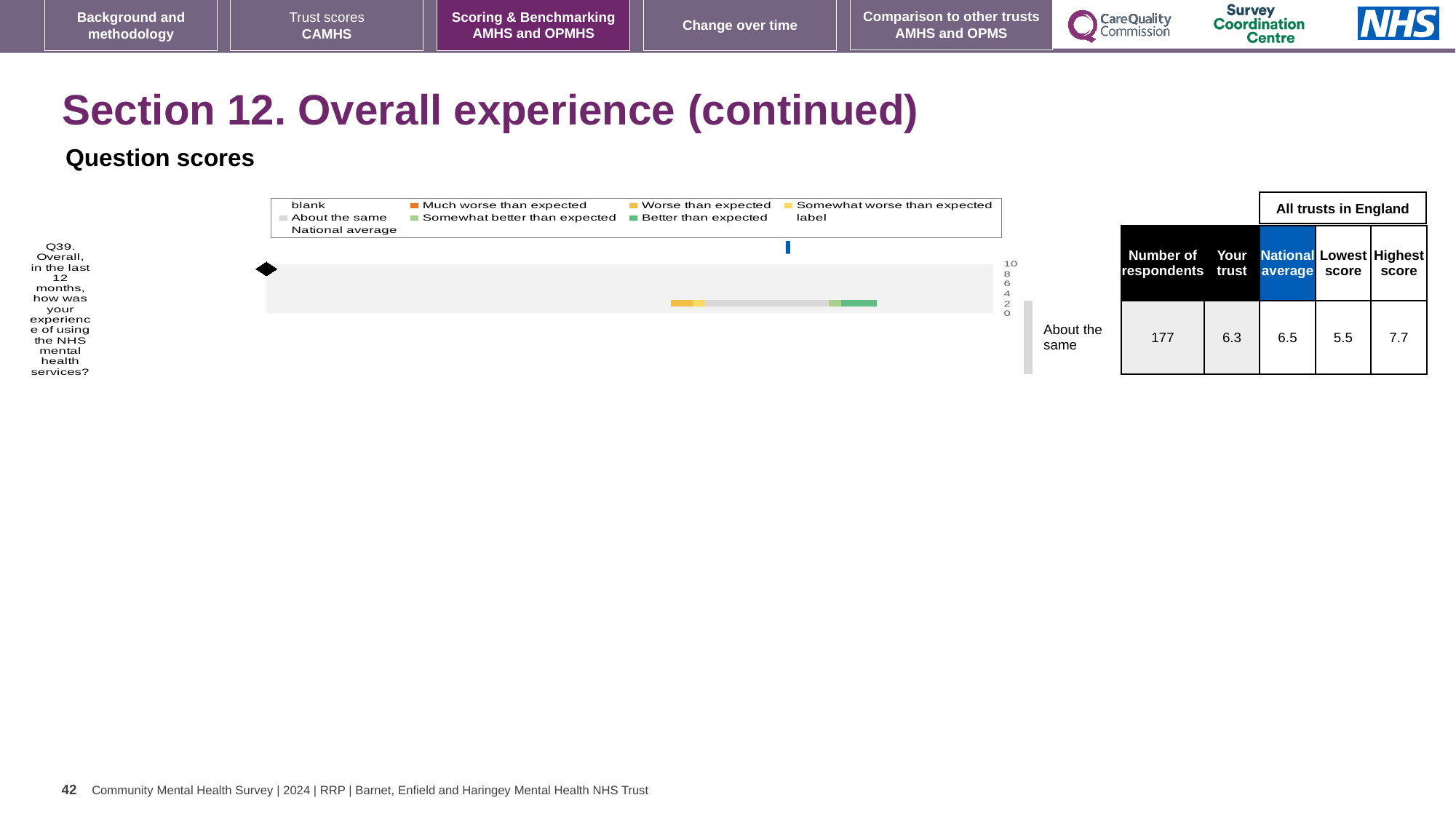
Which is larger for Q39, the 'Your trust' score or the national average? National average What is the highest score among all trusts in England for Q39? 7.7 What benchmark category label is shown to the right of the chart for Q39? About the same What is the difference between the highest score and the lowest score for Q39? 2.2 What is the national average score for Q39? 6.5 How many survey questions are plotted in the chart? 1 What kind of chart is shown on the slide? bar chart How many respondents answered Q39? 177 What is the lowest score among all trusts in England for Q39? 5.5 Which question number is plotted in the chart? Q39 What is the 'Your trust' score for Q39? 6.3 What is the difference between the national average and the 'Your trust' score for Q39? 0.2